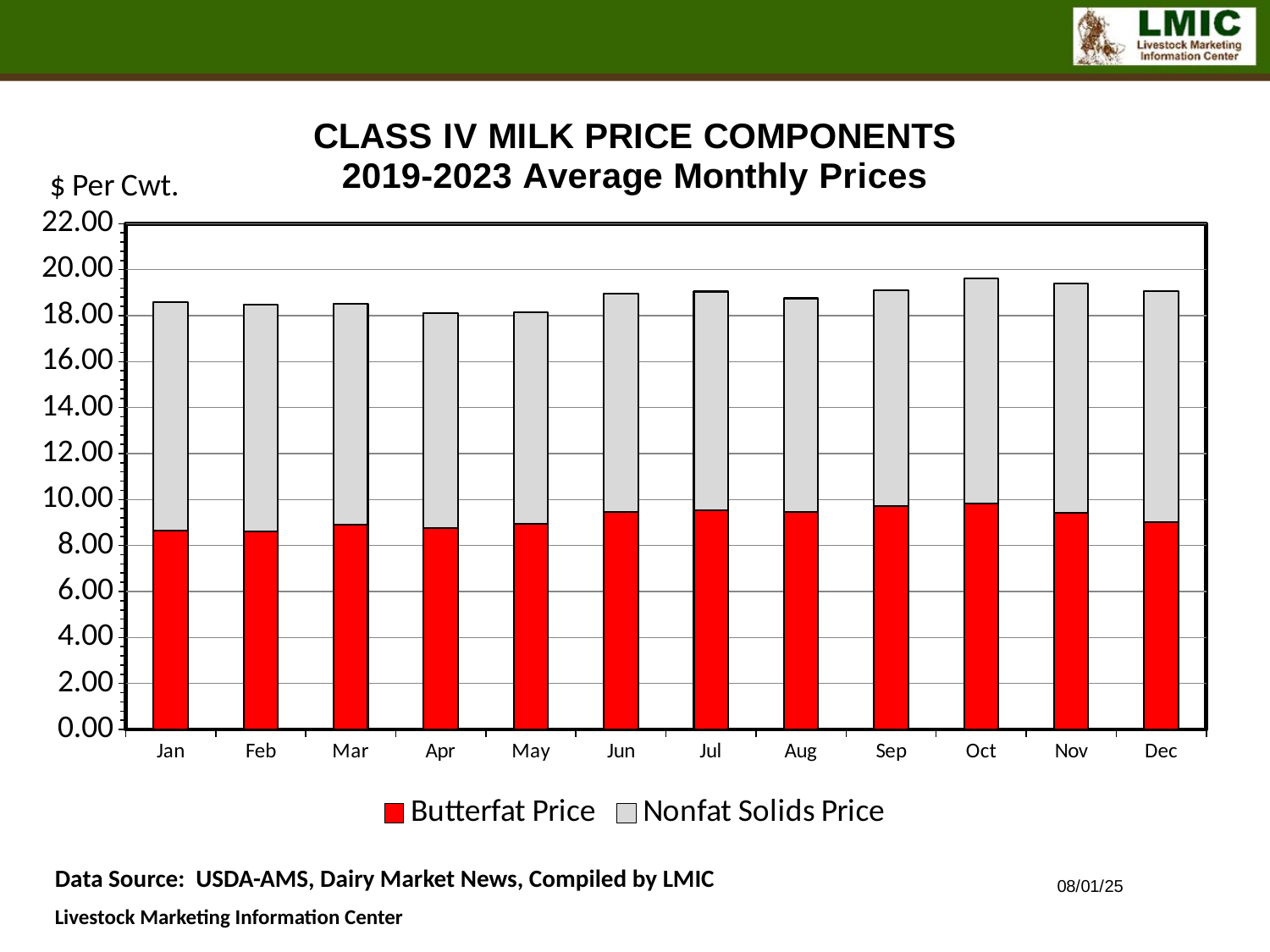
Which is larger, the Butterfat Price for Oct or for Feb? Oct Is the total stacked bar for Jan greater or less than 18.00? greater Which series is shown in red in the chart? Butterfat Price Is the Butterfat Price for Jan greater or less than 10.00? less How many series does the legend list? 2 What kind of chart is shown on the slide? Stacked bar chart What unit is shown on the y axis label of the chart? $ Per Cwt. Which month has the highest total Class IV milk price (top of the stacked bar)? Oct Which is larger, the total stacked bar for Oct or for Apr? Oct How many months are shown on the x axis of the chart? 12 Is the total stacked bar for Oct greater or less than 19.00? greater